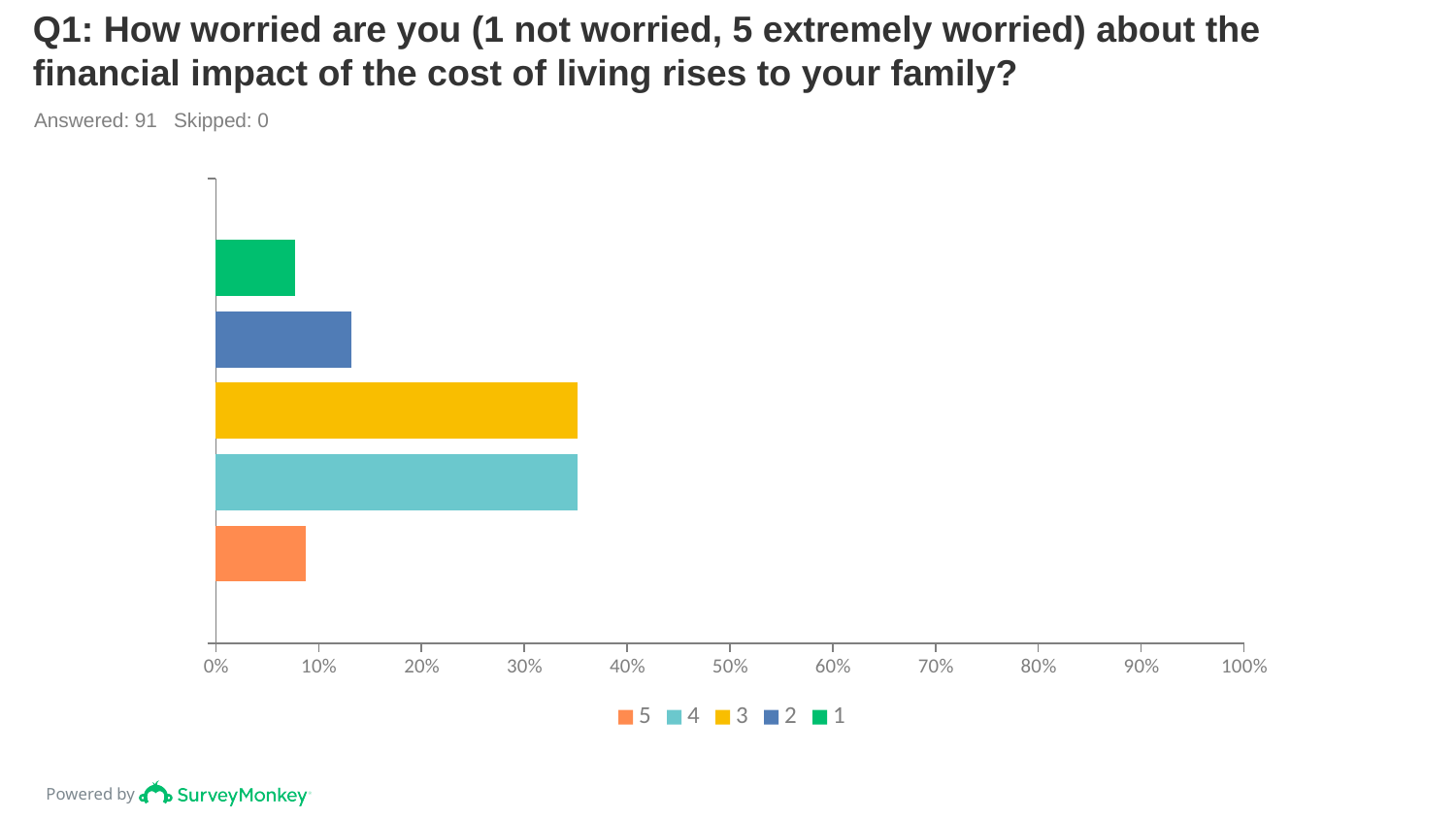
Which is larger, the value for rating 2 or the value for rating 1? rating 2 What kind of chart is shown on the slide? bar chart How many series does the legend list? 5 Is the value for rating 5 greater or less than 20%? less Is the value for rating 1 greater or less than 10%? less Is the value for rating 2 greater or less than 10%? greater How many bars are plotted in the chart? 5 Which is larger, the value for rating 3 or the value for rating 2? rating 3 How many respondents answered the question according to the slide? 91 Which is larger, the value for rating 4 or the value for rating 5? rating 4